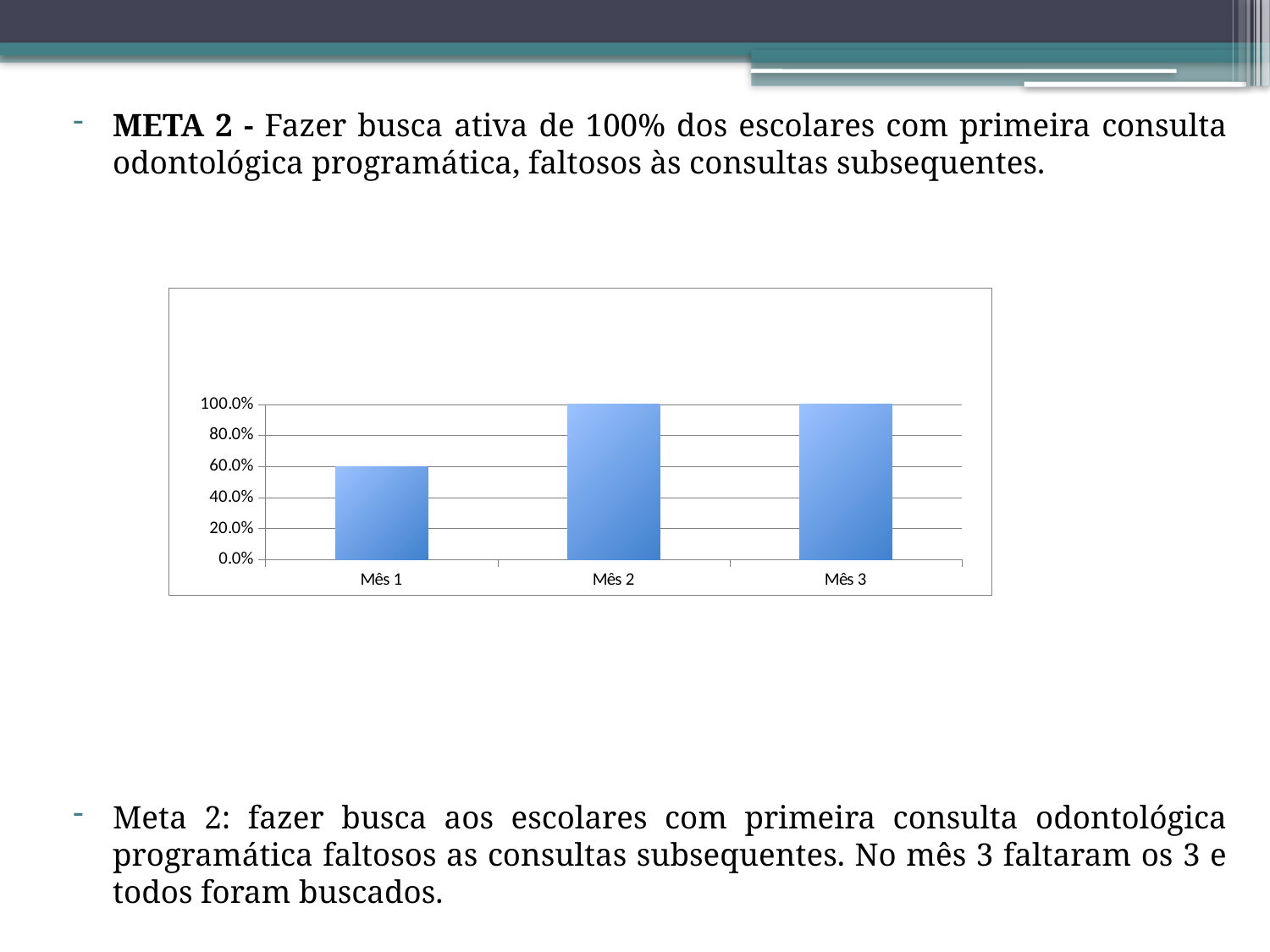
What is the value for Mês 1 in the chart? 60.0% Is the value for Mês 1 greater or less than 80.0%? less How many categories are shown on the x axis of the chart? 3 Do the values rise or fall from Mês 1 to Mês 2? rise What is the label of the first category on the x axis of the chart? Mês 1 What is the value for Mês 2 in the chart? 100.0% What kind of chart is shown on the slide? bar chart What is the value for Mês 3 in the chart? 100.0% Which category has the lowest value in the chart? Mês 1 What is the highest tick label shown on the y axis of the chart? 100.0% Which is larger, the value for Mês 1 or the value for Mês 2? Mês 2 What is the difference between the value for Mês 2 and the value for Mês 1? 40.0%